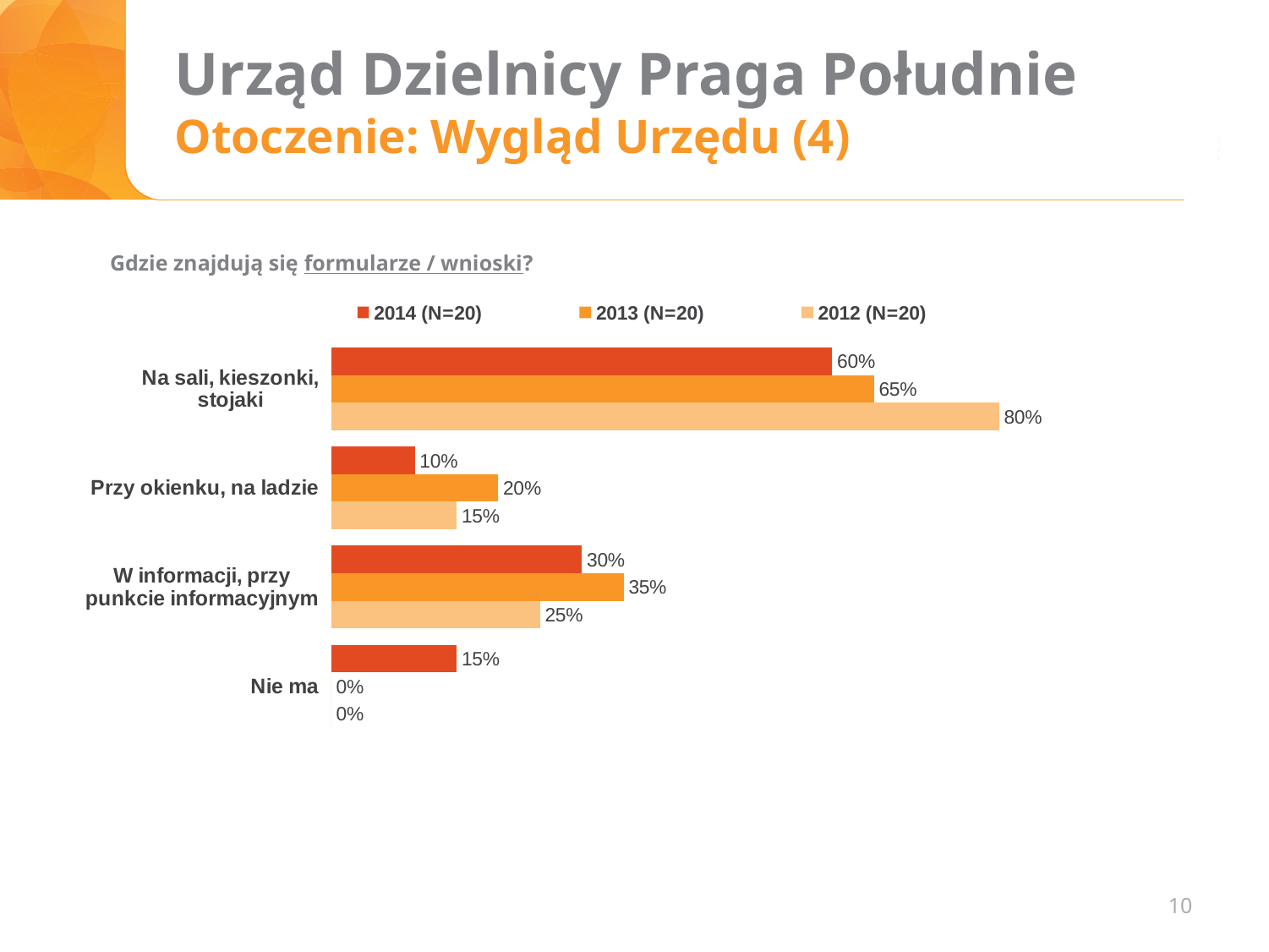
What question does the chart answer, as written above it? Gdzie znajdują się formularze / wnioski? How many categories are shown on the chart? 4 What is the difference between the 2012 (N=20) and 2014 (N=20) values for "Na sali, kieszonki, stojaki"? 20% What is the value for "Na sali, kieszonki, stojaki" in the 2014 (N=20) series? 60% What is the value for "Przy okienku, na ladzie" in the 2013 (N=20) series? 20% Which category has the lowest value in the 2013 (N=20) series? Nie ma What is the value for "Nie ma" in the 2014 (N=20) series? 15% Which category has the highest value in the 2012 (N=20) series? Na sali, kieszonki, stojaki What kind of chart is shown on the slide? Bar chart How many series does the legend list? 3 Which is larger for "W informacji, przy punkcie informacyjnym": the 2013 (N=20) value or the 2014 (N=20) value? 2013 (N=20) What is the value for "W informacji, przy punkcie informacyjnym" in the 2012 (N=20) series? 25%